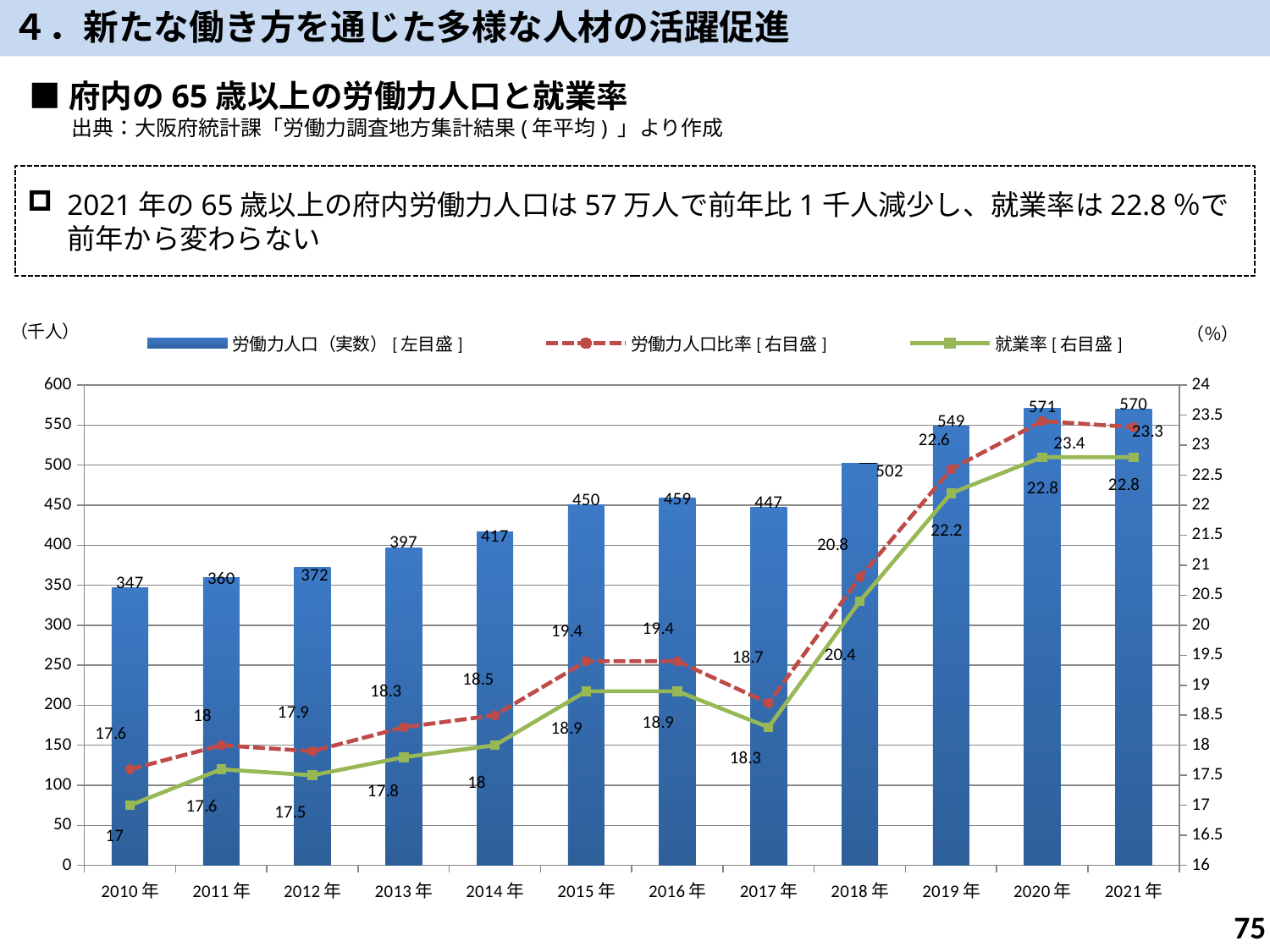
What is the difference between the labour force population in 2020年 and 2010年? 224 What is the 就業率 value shown for 2019年? 22.2 Does the 就業率 line rise or fall from 2017年 to 2020年? rise Which year has the highest labour force population bar? 2020年 What is the 労働力人口比率 value shown for 2018年? 20.8 Which is larger, the labour force population in 2016年 or in 2017年? 2016年 What kind of chart is used for the 労働力人口（実数） series? bar chart How many series does the legend list? 3 Which year has the lowest labour force population bar? 2010年 What is the unit shown at the top left of the left axis? 千人 What is the labour force population (労働力人口) value shown for 2021年? 570 How many years are shown on the x axis? 12